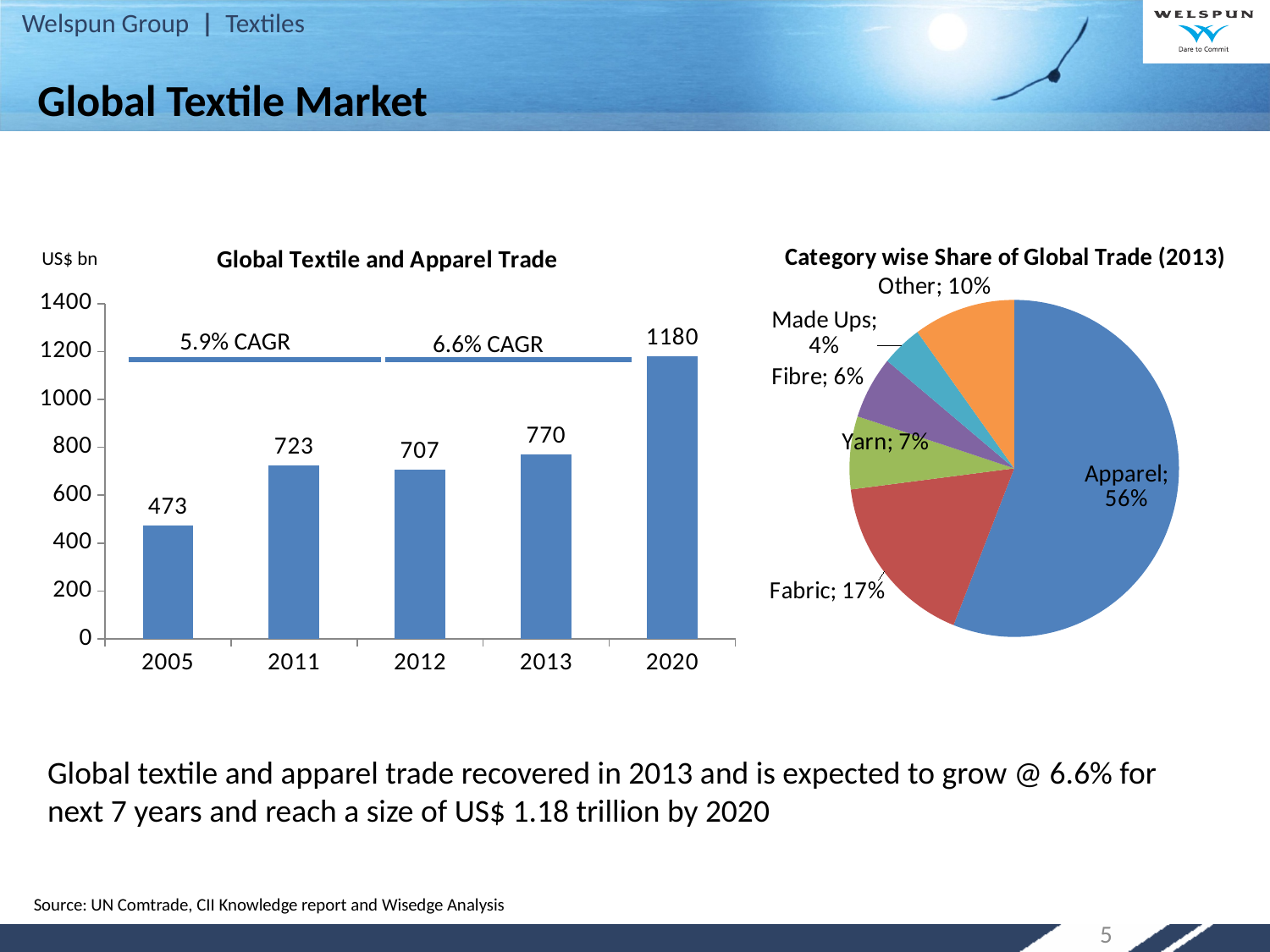
In the 'Global Textile and Apparel Trade' chart, what is the value for 2005? 473 In the 'Category wise Share of Global Trade (2013)' chart, what is the share for Fabric? 17% In the 'Global Textile and Apparel Trade' chart, what is the difference between the values for 2013 and 2012? 63 In the 'Global Textile and Apparel Trade' chart, what CAGR is shown between 2005 and 2011? 5.9% CAGR In the 'Global Textile and Apparel Trade' chart, how many years are shown on the x axis? 5 In the 'Category wise Share of Global Trade (2013)' chart, which category has the largest share? Apparel In the 'Global Textile and Apparel Trade' chart, which year has the lowest value? 2005 In the 'Category wise Share of Global Trade (2013)' chart, which category has the smallest share? Made Ups In the 'Global Textile and Apparel Trade' chart, what is the value for 2020? 1180 In the 'Global Textile and Apparel Trade' chart, which is larger, the value for 2011 or the value for 2012? 2011 In the 'Category wise Share of Global Trade (2013)' chart, how many categories are shown? 6 What kind of chart is 'Global Textile and Apparel Trade'? Bar chart